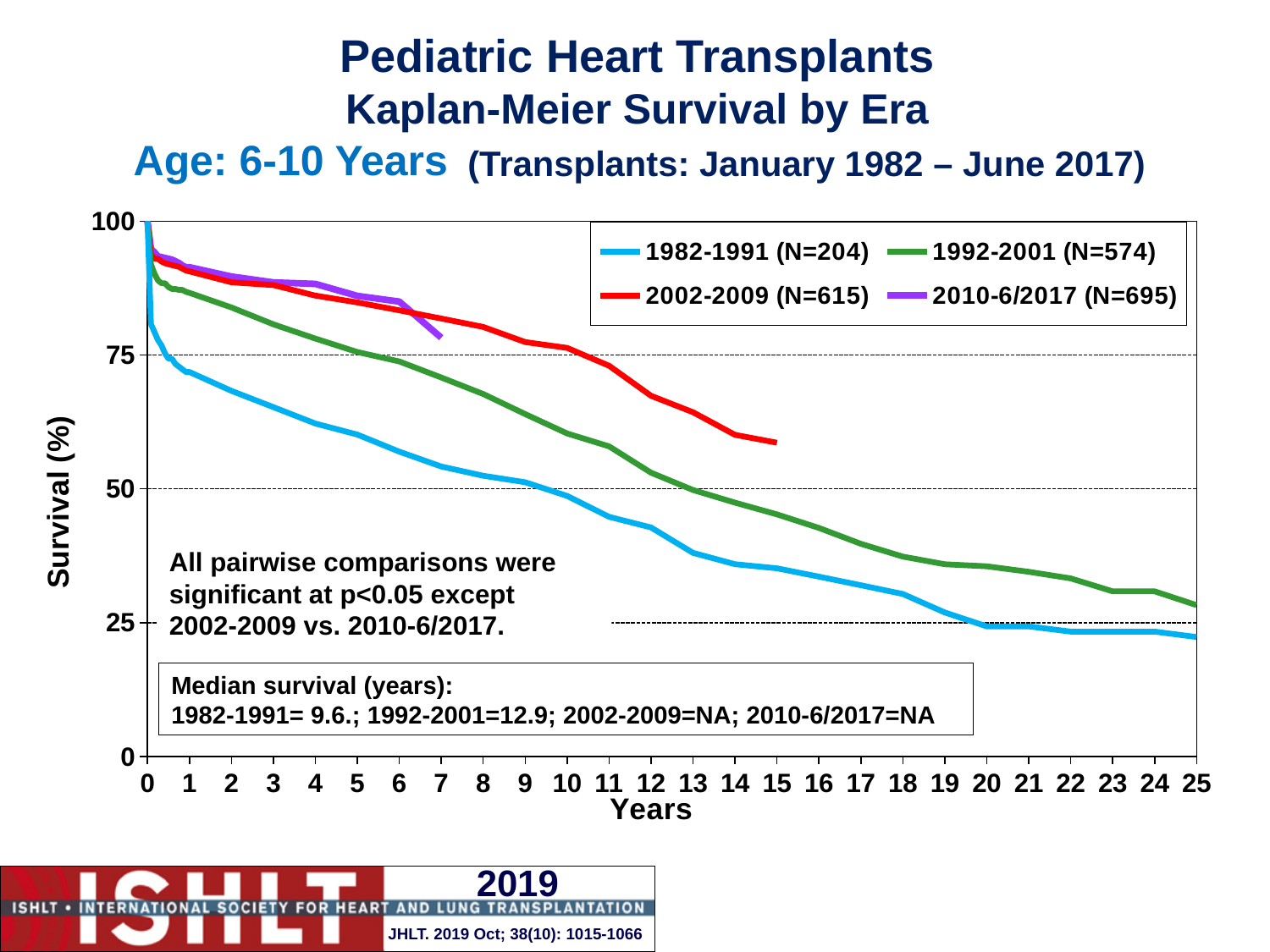
Is the survival for the 1982-1991 era at 10 years greater or less than 50? less What is the N for the 1992-2001 era in the legend? 574 Which era has the largest N in the legend? 2010-6/2017 (N=695) How many eras (series) does the legend list? 4 What kind of chart is shown on the slide? line chart Is the survival for the 2002-2009 era at 14 years greater or less than 50? greater Which era has the smallest N in the legend? 1982-1991 (N=204) At 10 years, which era has higher survival, 1982-1991 or 1992-2001? 1992-2001 What is the difference in median survival (years) between the 1992-2001 and 1982-1991 eras? 3.3 What is the median survival in years for the 1992-2001 era? 12.9 What is the label of the y axis? Survival (%) Do the survival curves rise or fall as years increase? fall